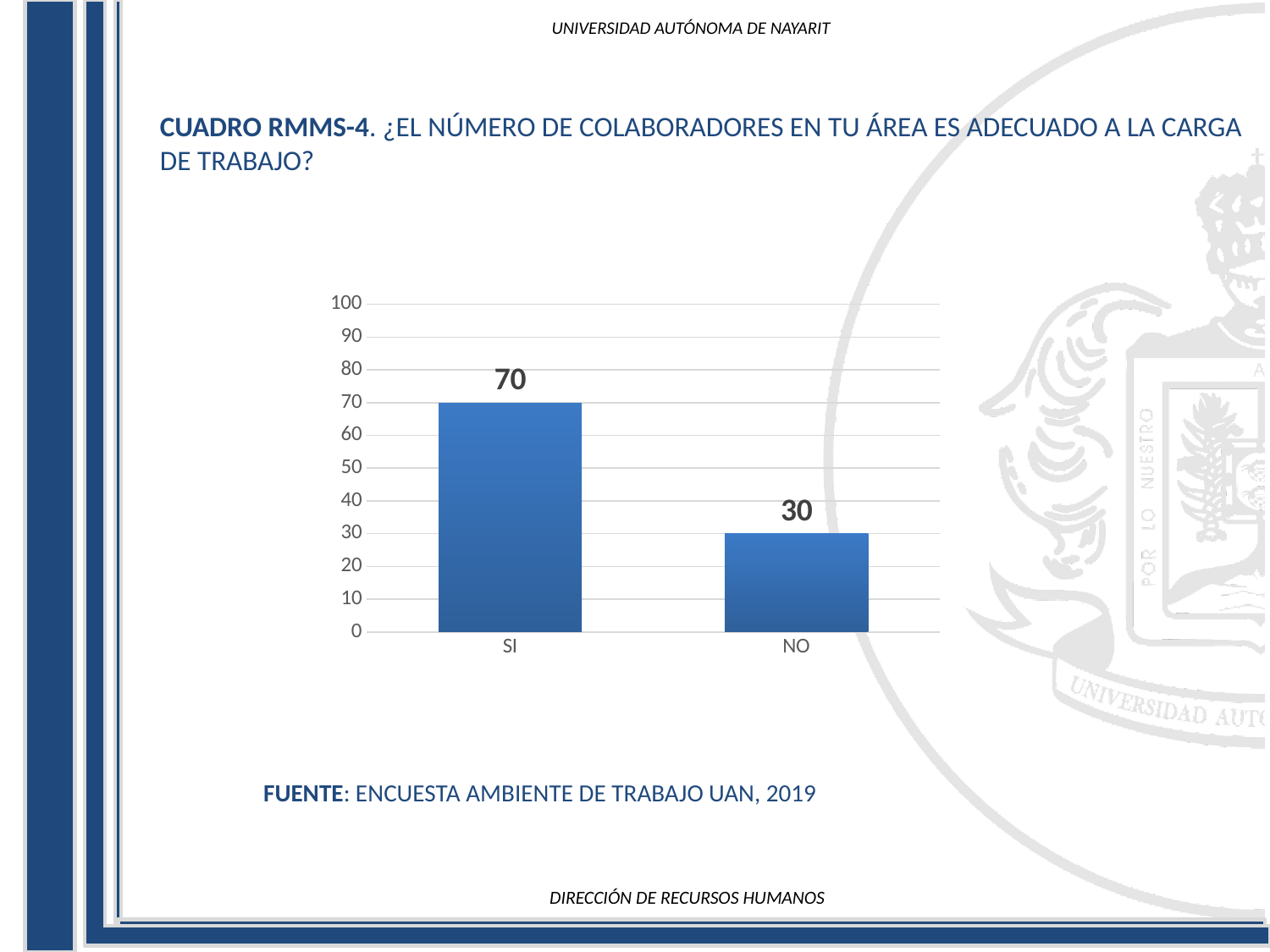
What is the value for SI? 70 What is the difference between the values for SI and NO? 40 What is the value for NO? 30 How many categories are shown on the x axis? 2 Which is larger, the value for SI or the value for NO? SI Is the value for SI greater or less than 50? greater Which category has the lowest value? NO Which category has the highest value? SI What is the maximum value shown on the y axis? 100 Is the value for NO greater or less than 50? less What kind of chart is shown on the slide? bar chart What is the total of the values for SI and NO? 100